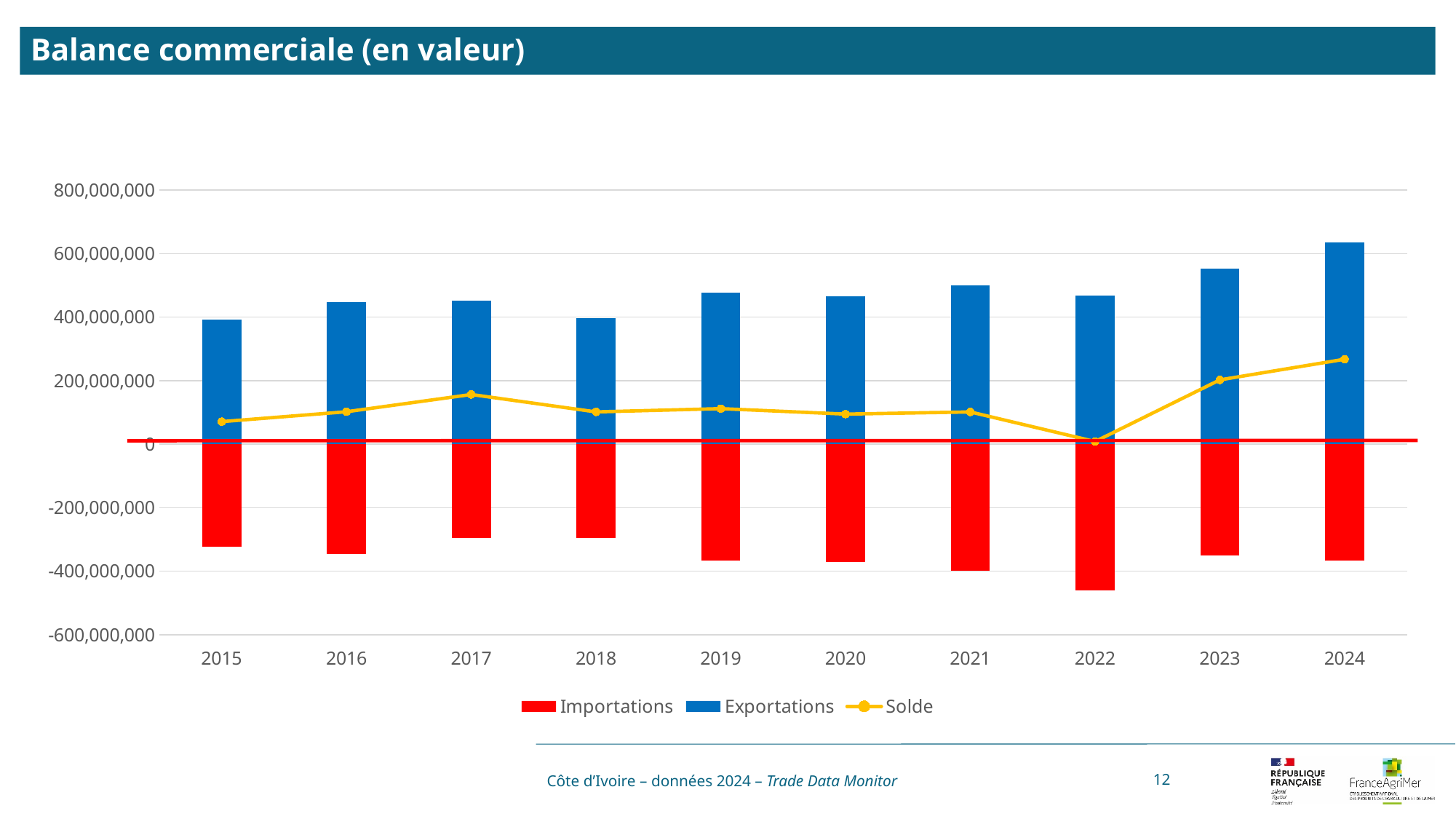
What kind of chart is this? Combined bar and line chart Is the Importations value for 2022 greater or less than -400,000,000? less How many years are shown on the x axis? 10 Which is larger, the Exportations value for 2023 or for 2021? 2023 Do the Exportations values rise or fall from 2022 to 2024? rise Which year has the lowest Solde value? 2022 Which year has the highest Exportations value? 2024 In which year do Importations reach their most negative value? 2022 What is the title of the chart? Balance commerciale (en valeur) Which year has the highest Solde value? 2024 Is the Exportations value for 2024 greater or less than 600,000,000? greater How many series does the legend list? 3